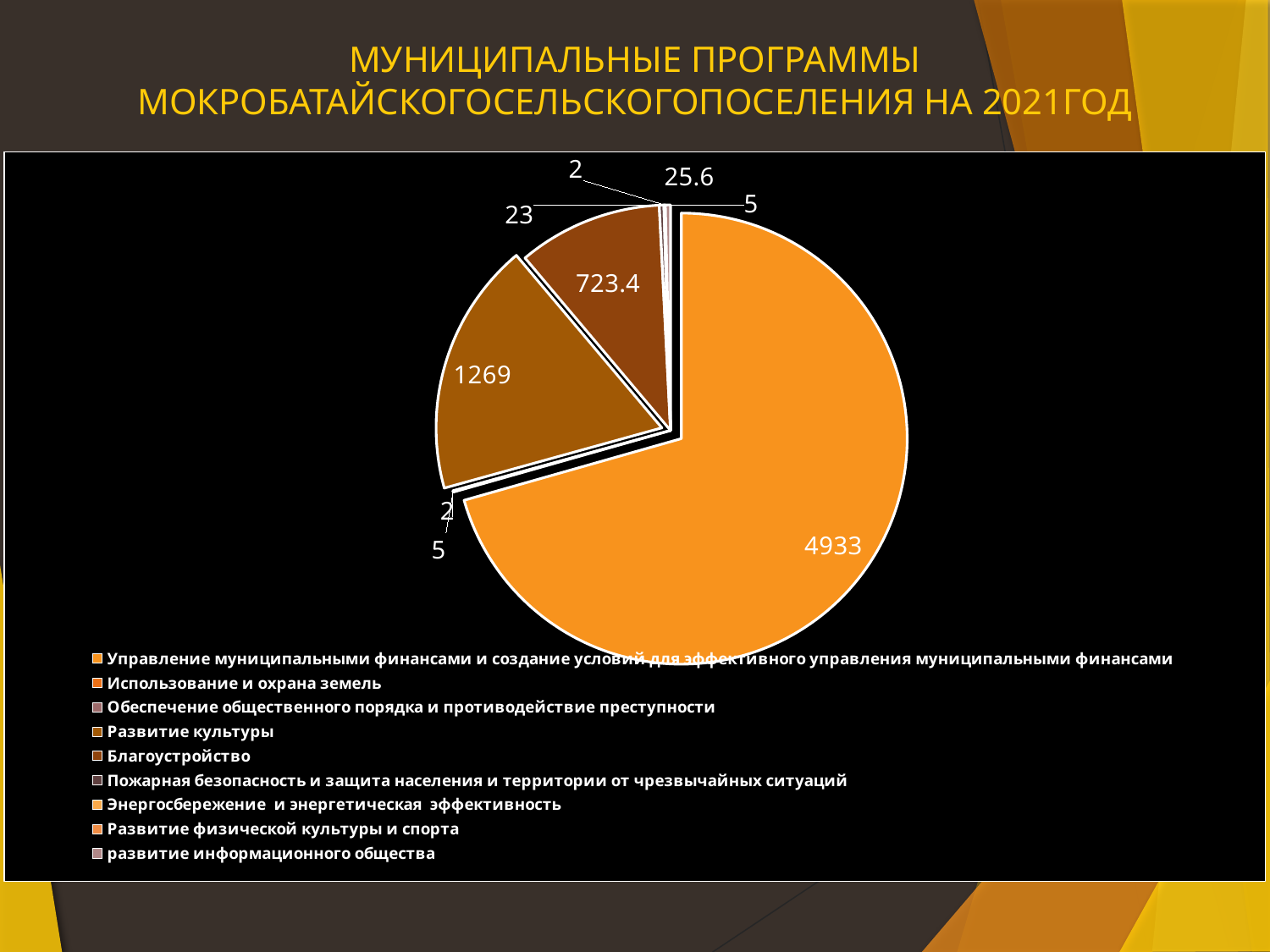
What kind of chart is shown on the slide? pie chart What is the last category listed in the legend of the pie chart? развитие информационного общества What is the difference between the two largest labelled values on the pie chart, 4933 and 1269? 3664 Which labelled value on the pie chart is larger, 25.6 or 23? 25.6 What is the second-largest value labelled on the pie chart? 1269 What is the value shown on the largest slice of the pie chart? 4933 What is the smallest value labelled on the pie chart? 2 Which legend category corresponds to the largest slice of the pie chart? Управление муниципальными финансами и создание условий для эффективного управления муниципальными финансами How many slices are labelled with values on the pie chart? 9 How many entries does the legend of the pie chart list? 9 Which labelled value on the pie chart is larger, 723.4 or 1269? 1269 What is the title of the slide containing the pie chart? МУНИЦИПАЛЬНЫЕ ПРОГРАММЫ МОКРОБАТАЙСКОГОСЕЛЬСКОГОПОСЕЛЕНИЯ НА 2021ГОД